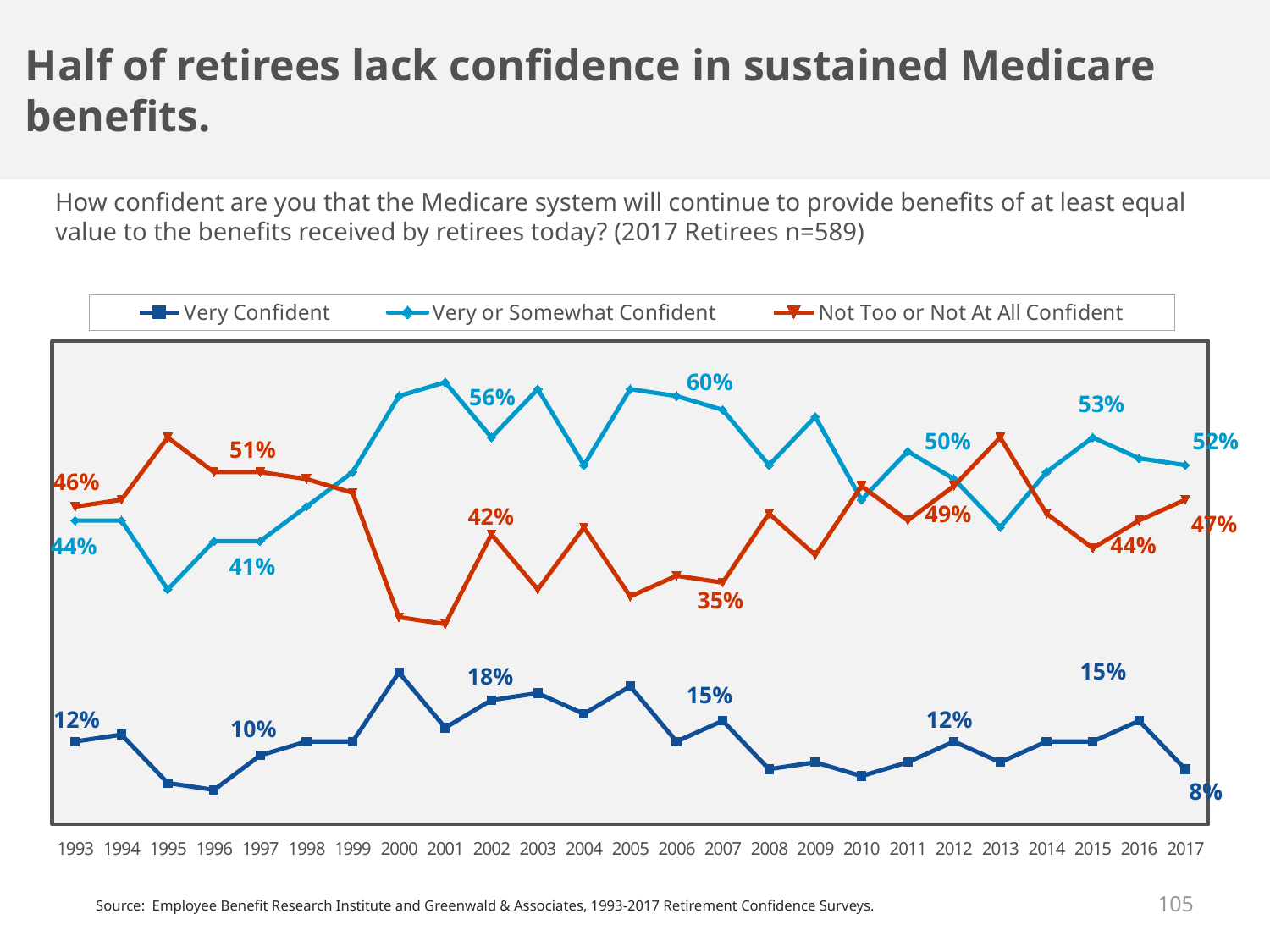
What kind of chart is shown on the slide? Line chart What is the value for Very Confident in 2017? 8% How many years are plotted along the x axis? 25 What is the value for Not Too or Not At All Confident in 1993? 46% In which year does the Very Confident series reach its highest point? 2000 In 2017, which is larger: Very or Somewhat Confident or Not Too or Not At All Confident? Very or Somewhat Confident What is the difference between Very or Somewhat Confident and Not Too or Not At All Confident in 2017? 5 percentage points What is the value for Not Too or Not At All Confident in 2017? 47% What is the value for Very or Somewhat Confident in 2017? 52% What is the value for Very Confident in 1993? 12% How many series does the legend list? 3 In which year does the Very or Somewhat Confident series reach its lowest point? 1995